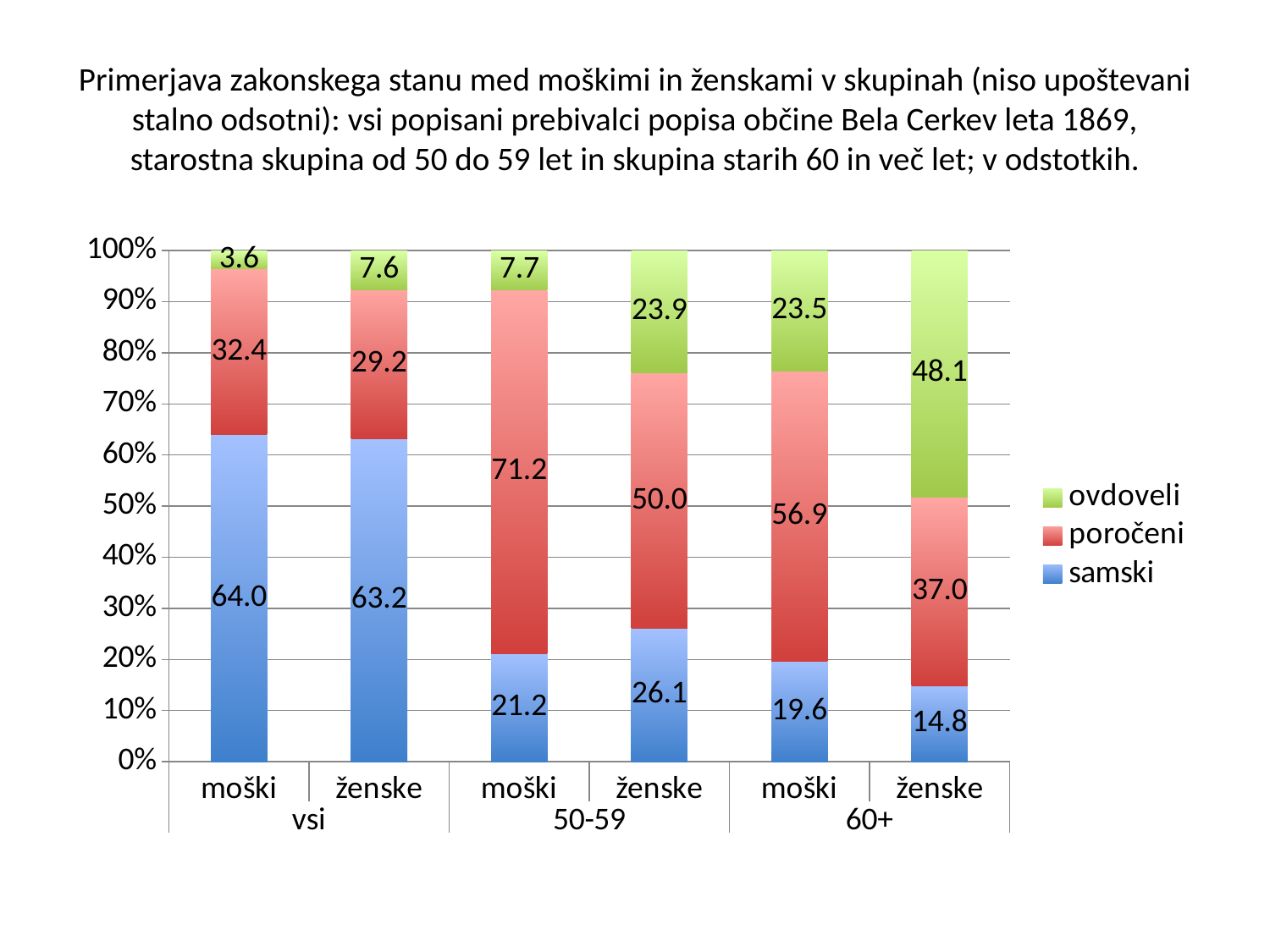
What is the value of poročeni for moški in the 50-59 group? 71.2 What is the value of samski for ženske in the 50-59 group? 26.1 How many bars are plotted in the chart? 6 What kind of chart is shown on the slide? stacked bar chart Which bar has the lowest value for samski? ženske, 60+ What is the value of ovdoveli for ženske in the 60+ group? 48.1 How many series does the legend list? 3 What is the difference between the poročeni values for moški and ženske in the 50-59 group? 21.2 Which series is shown in green in the legend? ovdoveli Which is larger: the ovdoveli value for moški in the 60+ group or for ženske in the 50-59 group? ženske in the 50-59 group What is the value of samski for moški in the vsi group? 64.0 Which bar has the highest value for ovdoveli? ženske, 60+